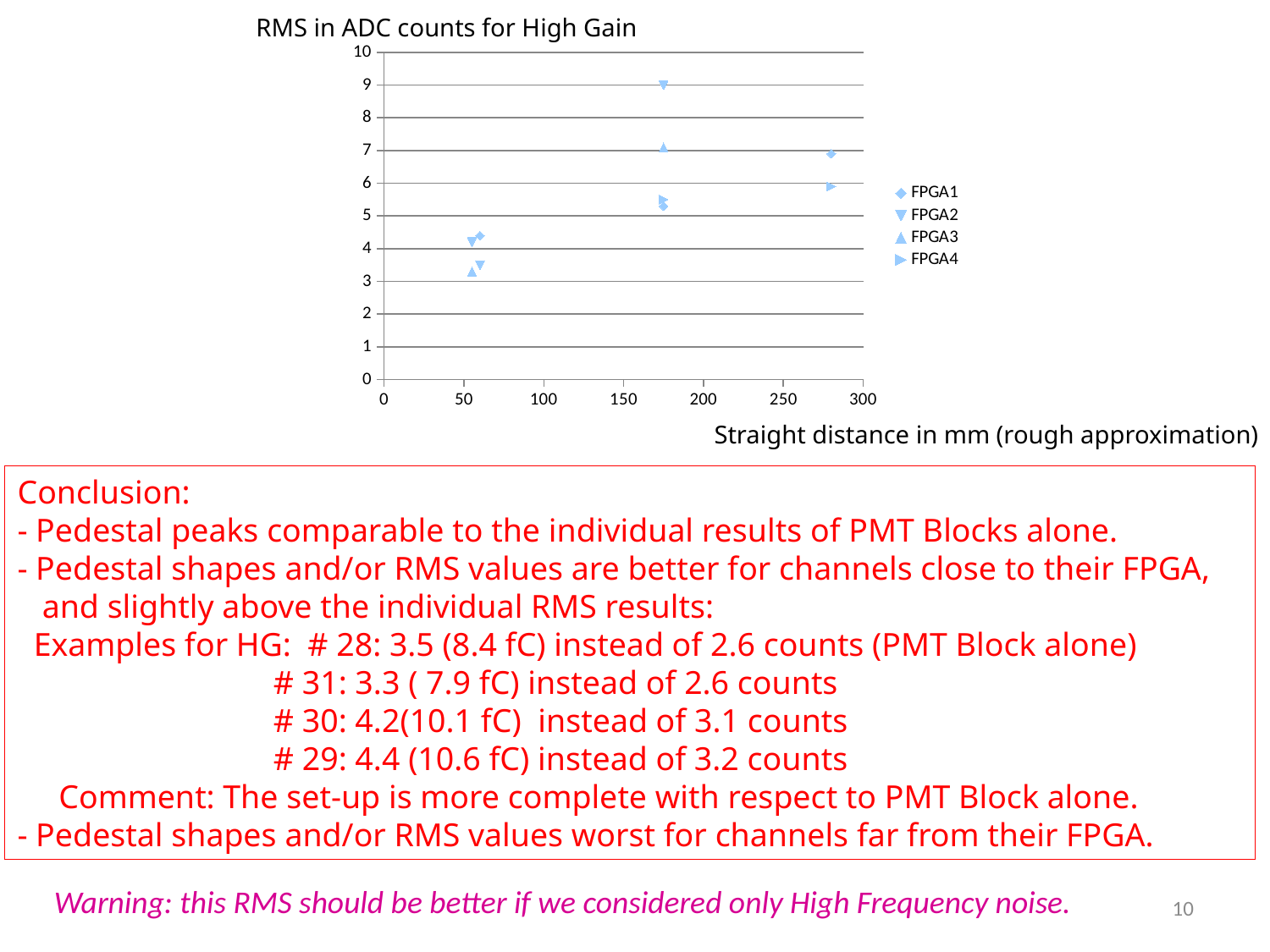
Is the FPGA3 point near 175 mm with the higher value greater or less than 6? greater Is the highest FPGA2 point greater or less than 8? greater What is the x-axis label of the chart? Straight distance in mm (rough approximation) How many series does the legend list? 4 Is the FPGA1 point near 280 mm greater or less than 6? greater What kind of chart is shown on the slide? scatter chart What is the maximum value shown on the y axis? 10 Which is larger: the FPGA1 point near 280 mm or the FPGA4 point near 280 mm? FPGA1 What is the title of the chart? RMS in ADC counts for High Gain Which series has the highest plotted point on the chart? FPGA2